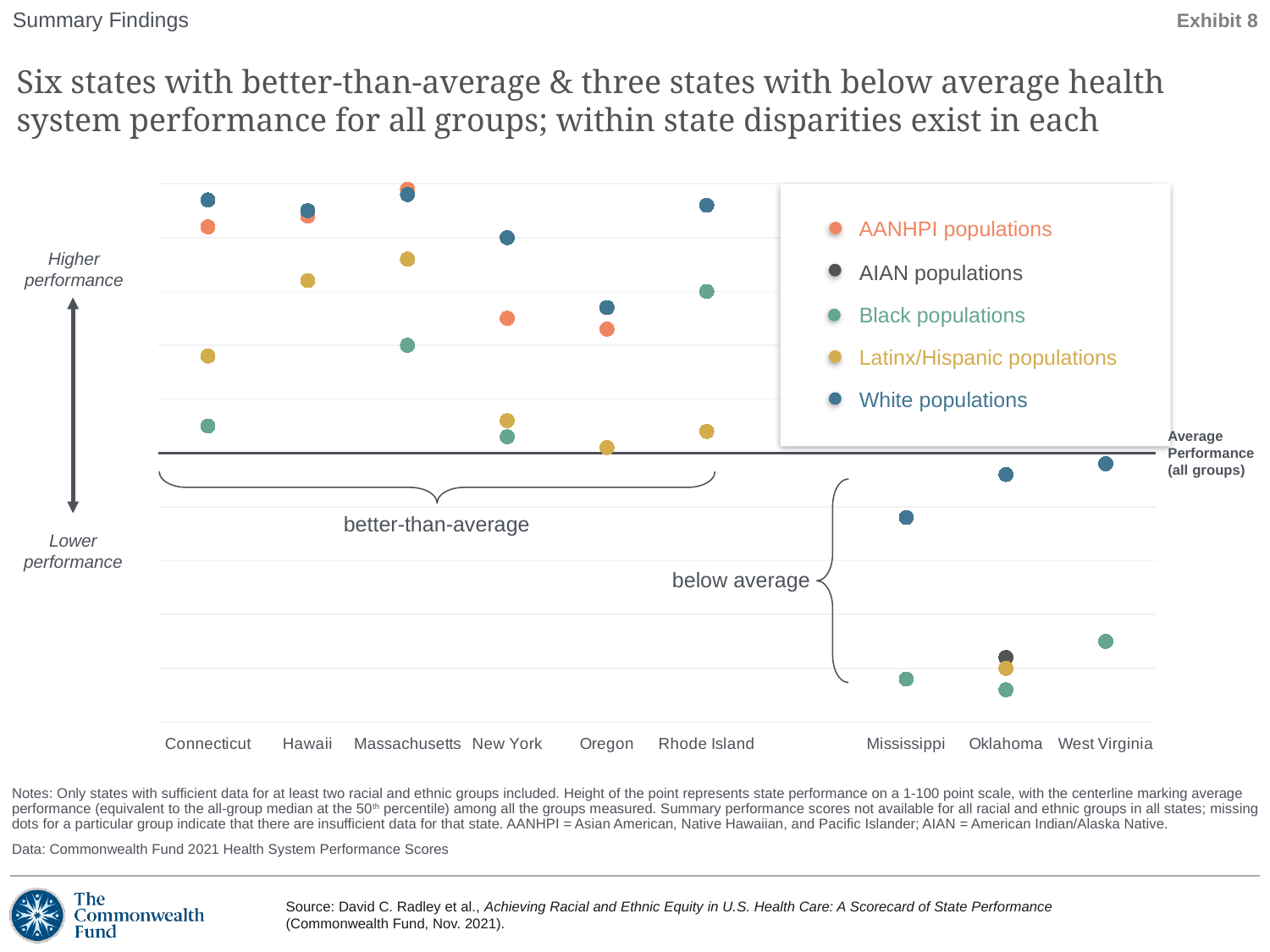
Is the point for White populations in Mississippi above or below the Average Performance (all groups) line? below How many states are shown along the x axis of the chart? 9 In Mississippi, which is higher: the point for White populations or the point for Black populations? White populations How many population groups does the chart's legend list? 5 In New York, which population group has the highest point on the chart? White populations How many population-group points are plotted for West Virginia? 2 How many states are grouped under the 'better-than-average' bracket in the chart? 6 Which population group is shown in orange in the chart's legend? AANHPI populations Which states are grouped under the 'below average' bracket in the chart? Mississippi, Oklahoma, West Virginia What kind of chart is shown on the slide? Dot plot (scatter chart) In Connecticut, which population group has the lowest point on the chart? Black populations In West Virginia, which is higher: the point for Black populations or the point for White populations? White populations